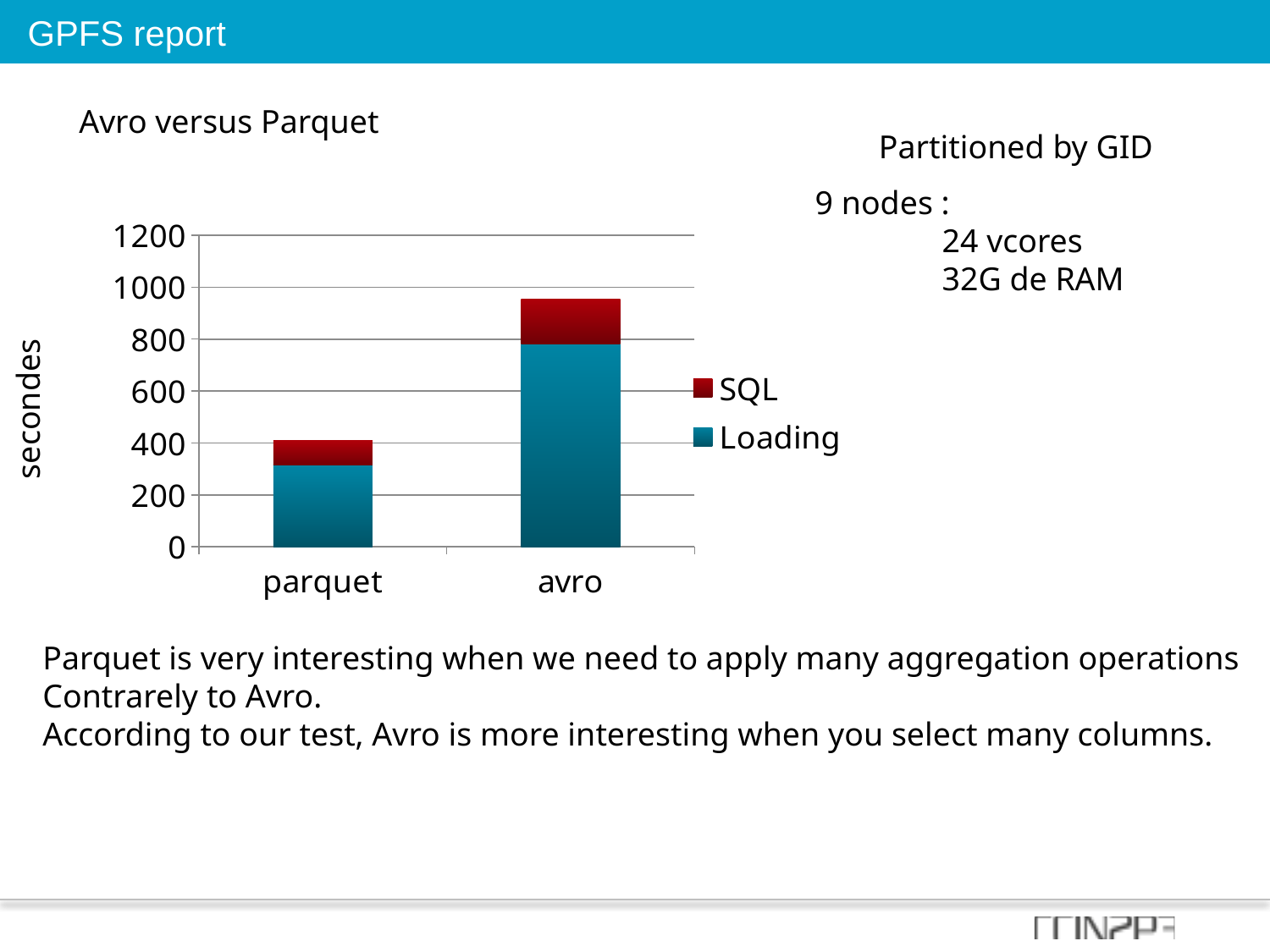
How many series does the chart legend list? 2 Is the Loading value for avro greater or less than 600? greater How many categories are shown on the x axis of the chart? 2 Is the Loading value for parquet greater or less than 400? less What is the label on the vertical axis of the chart? secondes What are the two series named in the chart legend? SQL and Loading Which category has the taller stacked bar, parquet or avro? avro What kind of chart is shown on the slide? stacked bar chart Which category has the lowest total bar height? parquet Which category has the larger Loading value, parquet or avro? avro Is the total value for avro greater or less than 800? greater